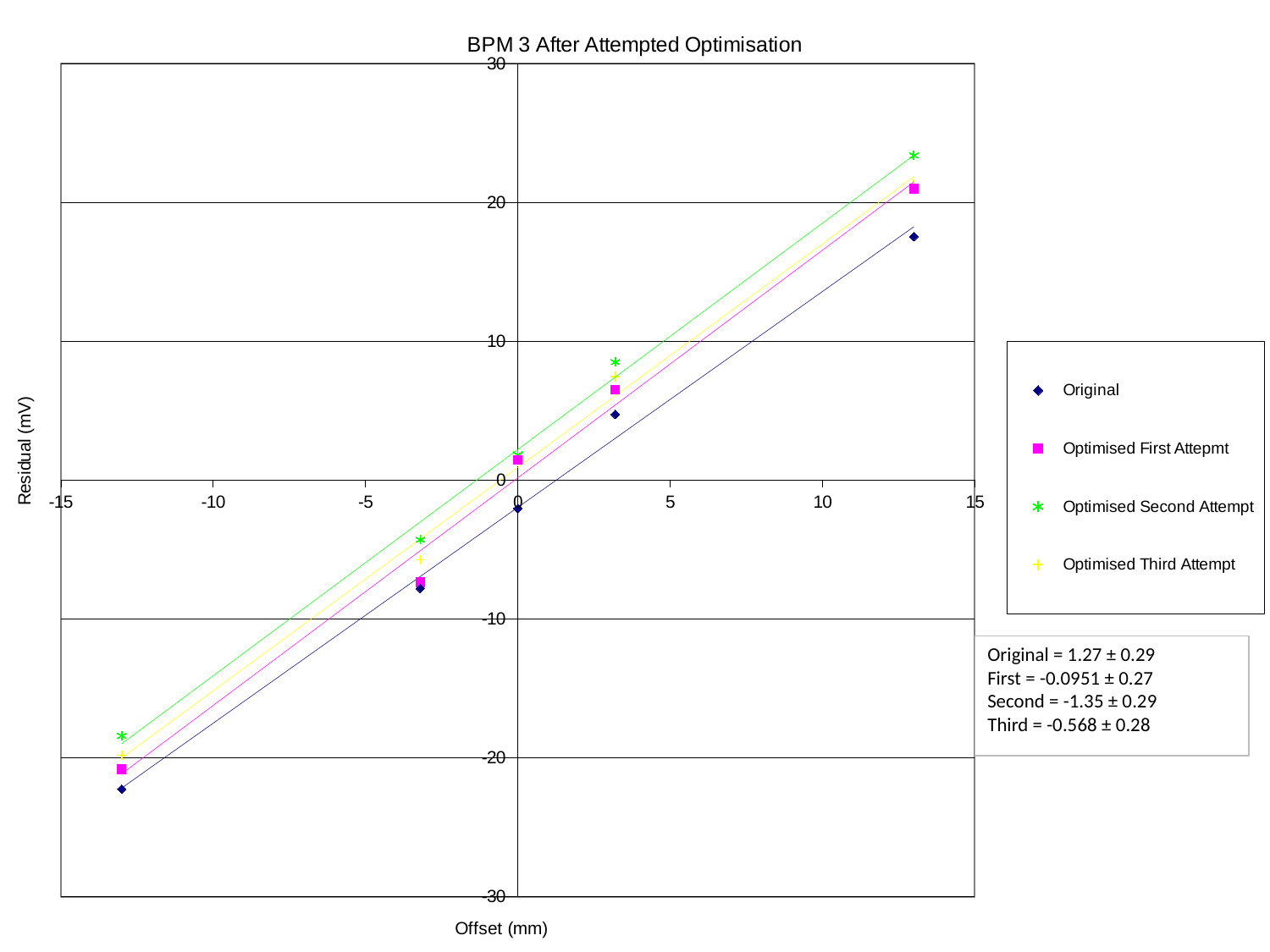
What is the title of the chart? BPM 3 After Attempted Optimisation What kind of chart is shown on the slide? scatter chart Is the Optimised Second Attempt value at the largest offset (around 13 mm) greater or less than 20? greater At the largest offset (around 13 mm), which series has the higher residual: Original or Optimised Second Attempt? Optimised Second Attempt Is the Original series value at the largest offset (around 13 mm) greater or less than 20? less Which series has the highest residual value at the largest offset (around 13 mm)? Optimised Second Attempt Is the Optimised Second Attempt value at the smallest offset (around -13 mm) greater or less than -20? greater What is the label of the x axis? Offset (mm) Do the Residual values rise or fall as Offset increases along the x axis? rise How many series does the legend list? 4 How many data points are plotted for the Original series? 5